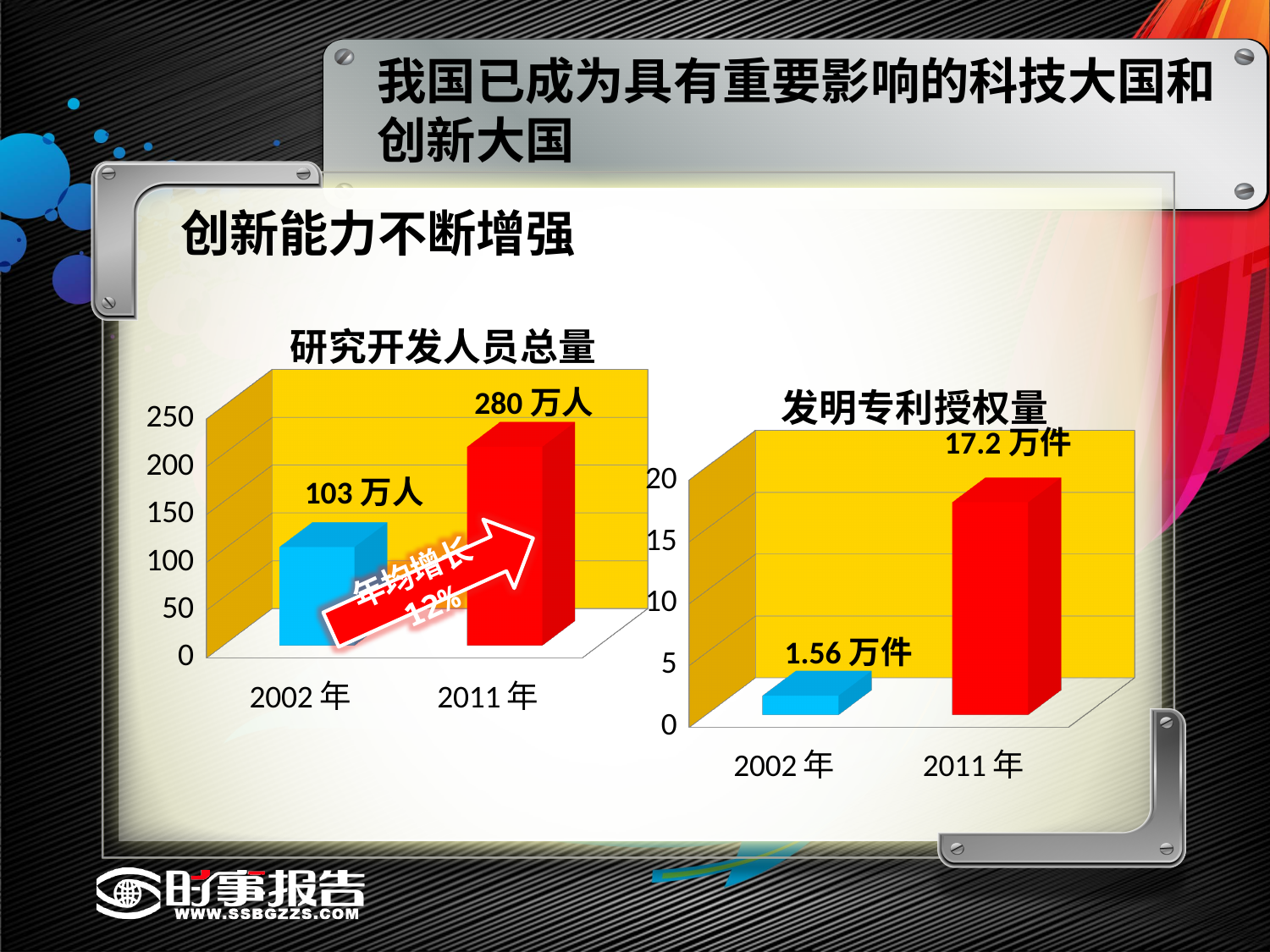
How many categories are shown in the chart titled 发明专利授权量? 2 In the chart titled 研究开发人员总量, is the value for 2002年 greater or less than 150? less In the chart titled 发明专利授权量, what is the value for 2002年? 1.56 万件 In the chart titled 发明专利授权量, what is the difference between the 2011年 and 2002年 values? 15.64 万件 In the chart titled 研究开发人员总量, what is the value for 2002年? 103 万人 In the chart titled 发明专利授权量, what is the value for 2011年? 17.2 万件 In the chart titled 发明专利授权量, which year has the lower value? 2002年 In the chart titled 研究开发人员总量, what is the value for 2011年? 280 万人 In the chart titled 研究开发人员总量, what annual growth rate is written on the arrow? 年均增长 12% What kind of chart is the chart titled 研究开发人员总量? bar chart In the chart titled 研究开发人员总量, what is the difference between the 2011年 and 2002年 values? 177 万人 In the chart titled 研究开发人员总量, which year has the higher value? 2011年